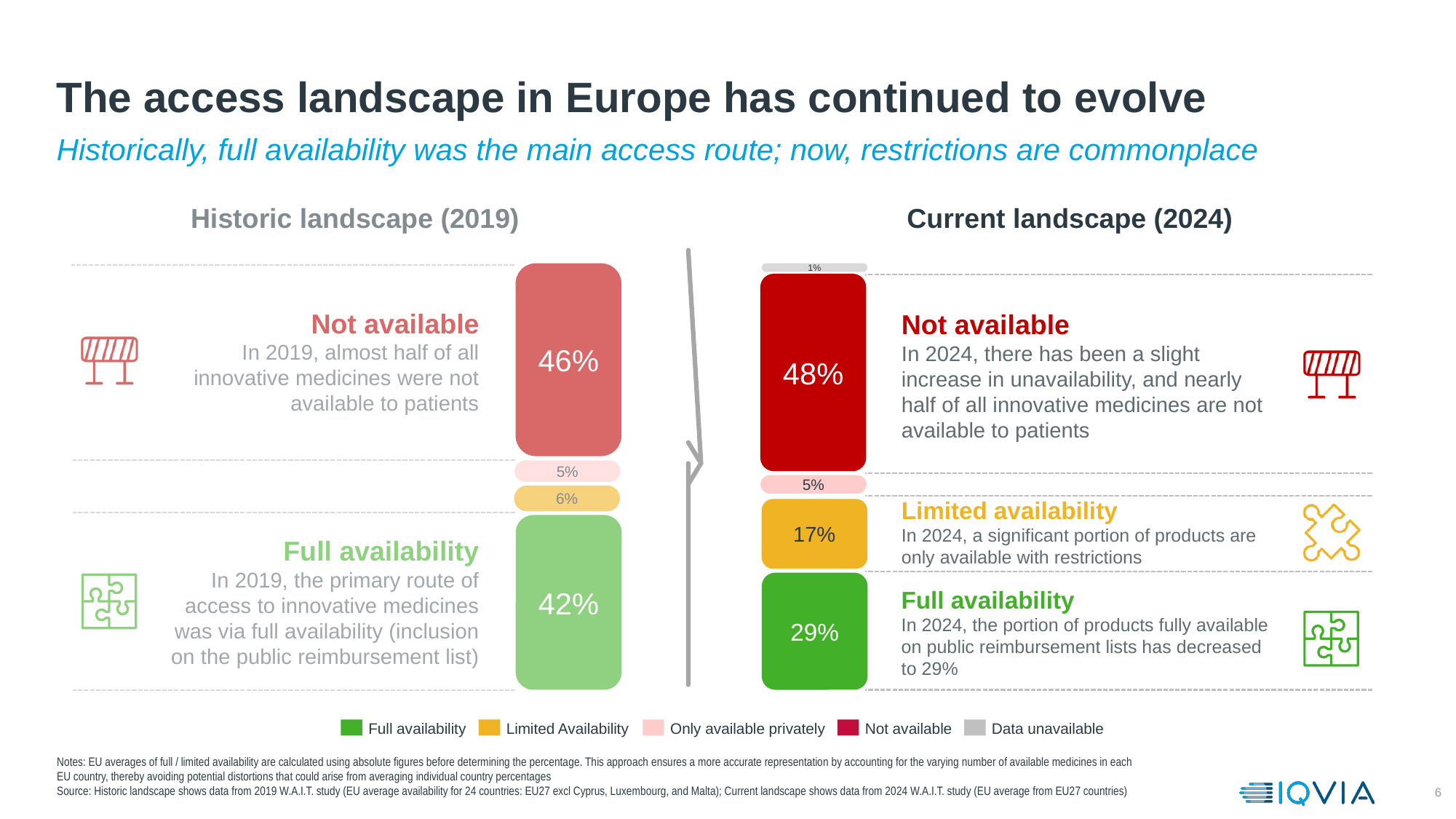
In the Historic landscape (2019) chart, what percentage is shown for the limited availability segment? 6% In the Historic landscape (2019) chart, which segment is the largest? Not available In the Current landscape (2024) chart, what percentage is shown for full availability? 29% In the Current landscape (2024) chart, which segment is the smallest? Data unavailable What is the difference between the full availability percentage in 2019 and in 2024? 13% In the Current landscape (2024) chart, what percentage is shown for the data unavailable segment? 1% In the Historic landscape (2019) chart, what percentage of innovative medicines were not available? 46% What colour represents limited availability in the legend? Orange How many entries does the legend list? 5 What kind of chart is used to show the Historic landscape (2019) and Current landscape (2024)? Stacked bar chart Which is larger: the not available share in 2019 or in 2024? 2024 In the Current landscape (2024) chart, what percentage is shown for limited availability? 17%